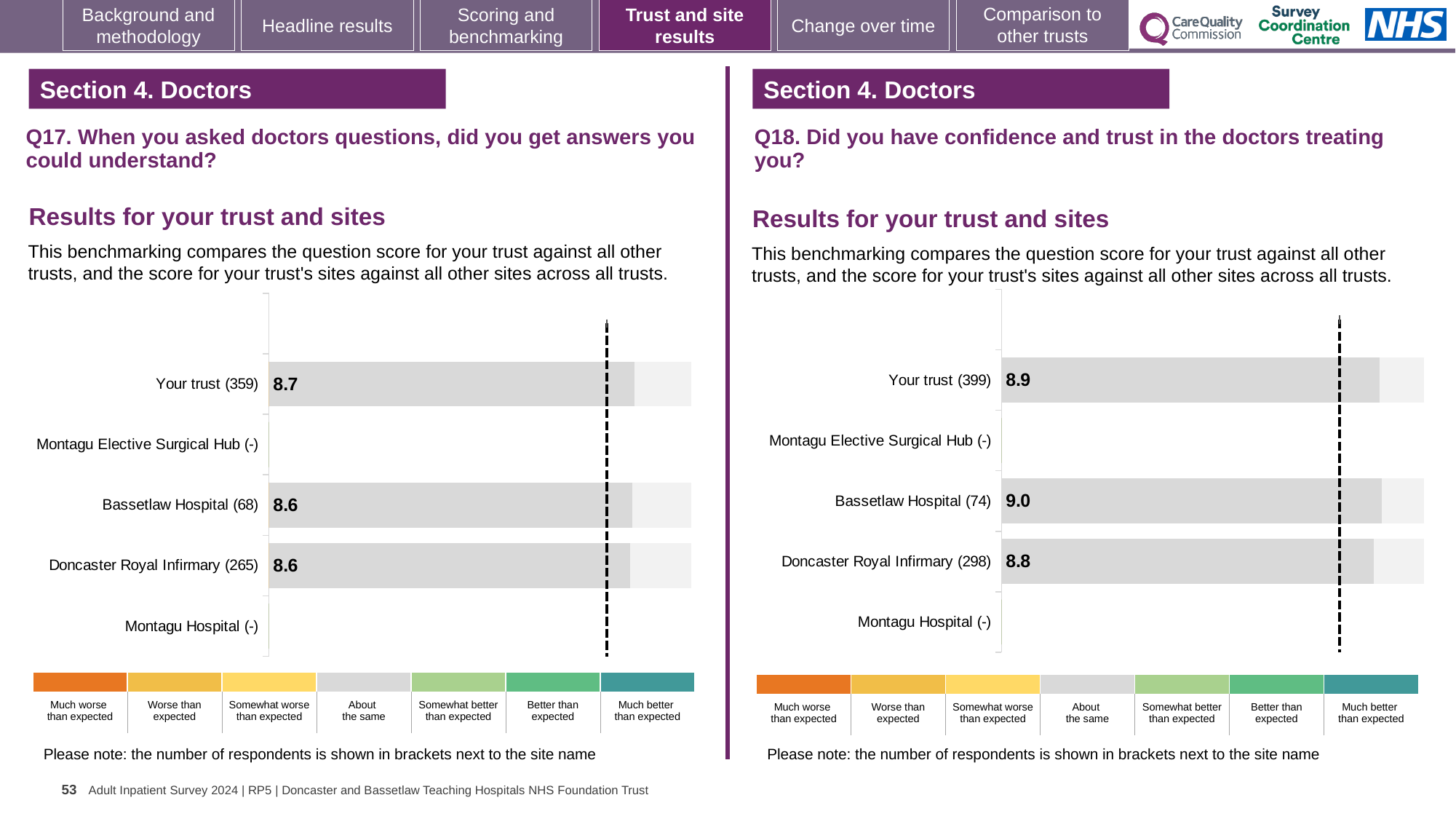
In the Q18 chart on the right, which site or trust has the highest score? Bassetlaw Hospital How many sites or trusts are listed on the y axis of the Q17 chart on the left? 5 In the Q18 chart on the right, what is the score for Bassetlaw Hospital? 9.0 In the Q17 chart on the left, what is the difference between the scores for Your trust and Bassetlaw Hospital? 0.1 What kind of chart is used for the Q18 results on the right? Bar chart In the Q18 chart on the right, which has the higher score: Your trust or Doncaster Royal Infirmary? Your trust In the Q18 chart on the right, what is the score for Your trust? 8.9 In the Q18 chart on the right, which site or trust has the lowest score among those with a value shown? Doncaster Royal Infirmary In the Q18 chart on the right, what is the difference between the scores for Bassetlaw Hospital and Doncaster Royal Infirmary? 0.2 In the Q17 chart on the left, what is the score for Your trust? 8.7 In the Q17 chart on the left, how many respondents are shown in brackets for Your trust? 359 In the Q17 chart on the left, what is the score for Doncaster Royal Infirmary? 8.6